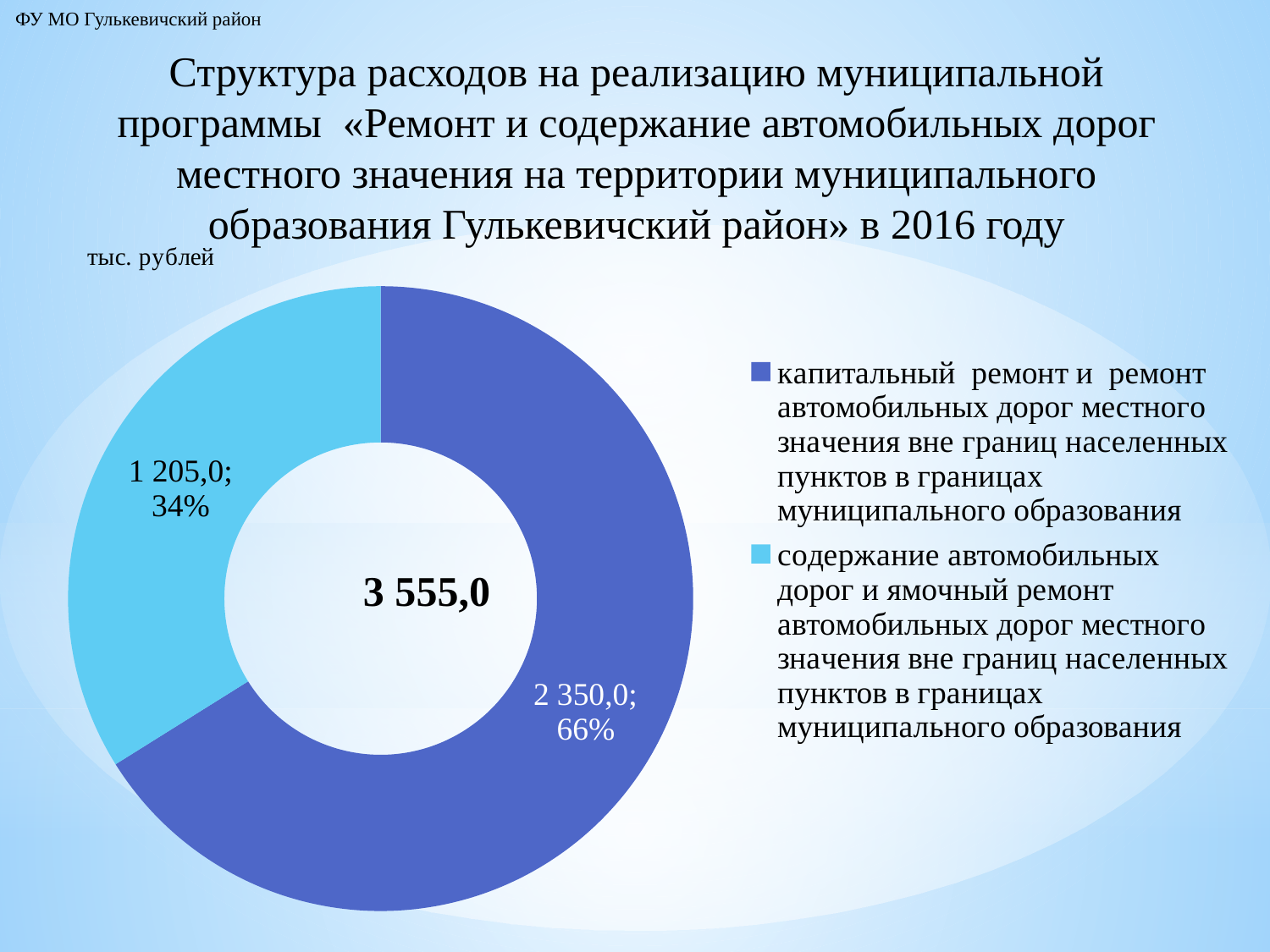
В каких единицах измерения приведены значения на диаграмме? тыс. рублей Какая общая сумма расходов указана в центре диаграммы? 3 555,0 Сколько категорий (секторов) показано на диаграмме? 2 Какая категория имеет наименьшее значение? содержание автомобильных дорог и ямочный ремонт автомобильных дорог местного значения вне границ населенных пунктов в границах муниципального образования Какую долю составляет сектор «содержание автомобильных дорог и ямочный ремонт»? 34% Какой тип диаграммы показан на слайде? кольцевая (круговая) диаграмма Какую долю составляет сектор «капитальный ремонт и ремонт автомобильных дорог»? 66% Какое значение (тыс. рублей) приходится на содержание автомобильных дорог и ямочный ремонт? 1 205,0 Сколько записей содержит легенда диаграммы? 2 Какое значение (тыс. рублей) приходится на капитальный ремонт и ремонт автомобильных дорог местного значения вне границ населенных пунктов? 2 350,0 Какая категория имеет наибольшее значение? капитальный ремонт и ремонт автомобильных дорог местного значения вне границ населенных пунктов в границах муниципального образования На сколько тыс. рублей расходы на капитальный ремонт превышают расходы на содержание дорог и ямочный ремонт? 1 145,0